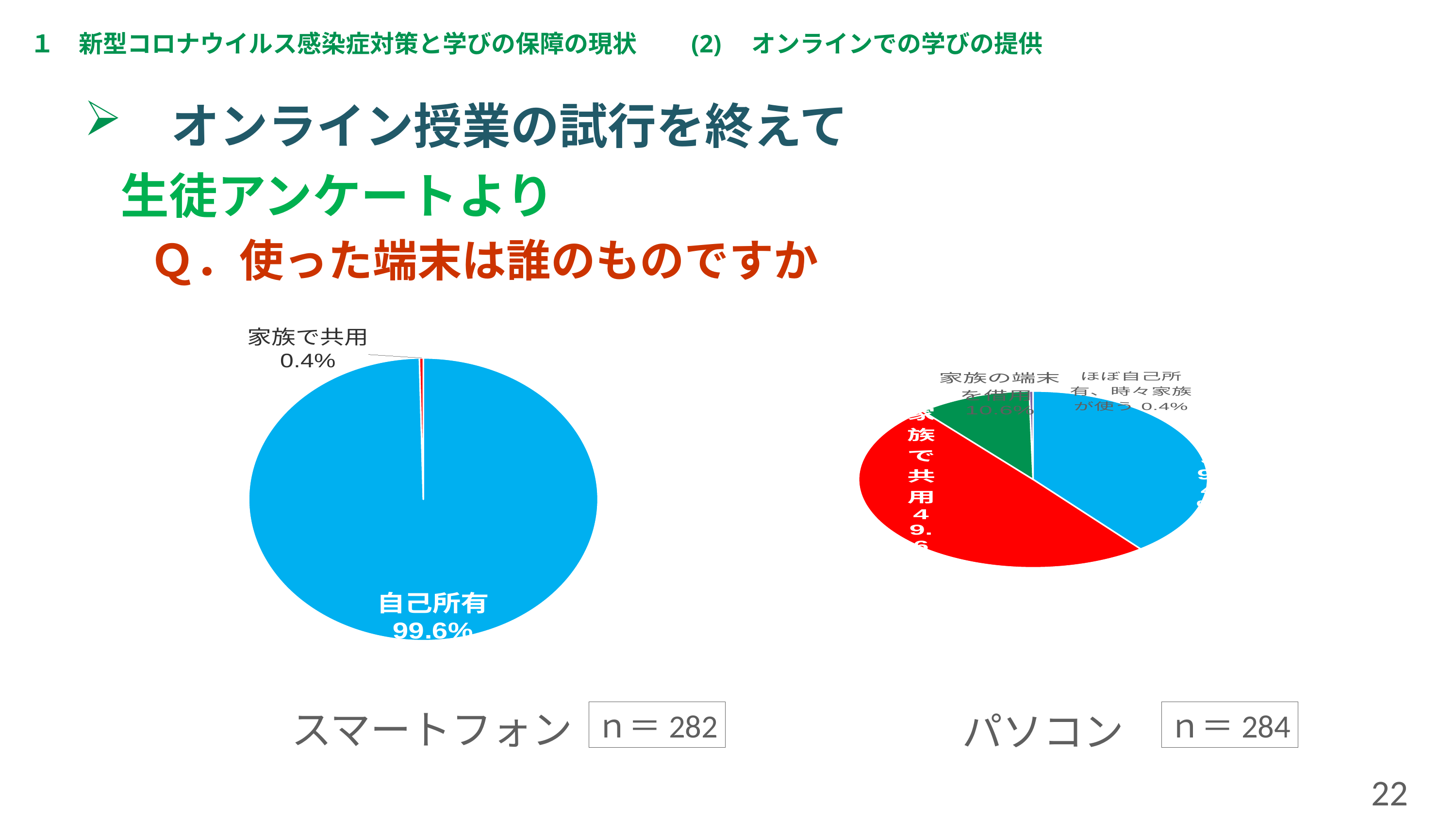
In the パソコン chart, what share is labelled 家族の端末を借用? 10.6% In the パソコン chart, how many slices does the pie have? 4 In the スマートフォン chart, how many slices does the pie have? 2 What is the n value shown for the パソコン chart? n＝284 In the スマートフォン chart, what share is labelled 自己所有? 99.6% What kind of chart is the スマートフォン chart? pie chart In the スマートフォン chart, what share is labelled 家族で共用? 0.4% In the パソコン chart, what share is labelled ほぼ自己所有、時々家族が使う? 0.4% In the スマートフォン chart, what is the difference between the 自己所有 share and the 家族で共用 share? 99.2 percentage points In the パソコン chart, which slice is the smallest? ほぼ自己所有、時々家族が使う In the パソコン chart, which is larger, the 家族で共用 slice or the 家族の端末を借用 slice? 家族で共用 In the スマートフォン chart, which slice is the largest? 自己所有